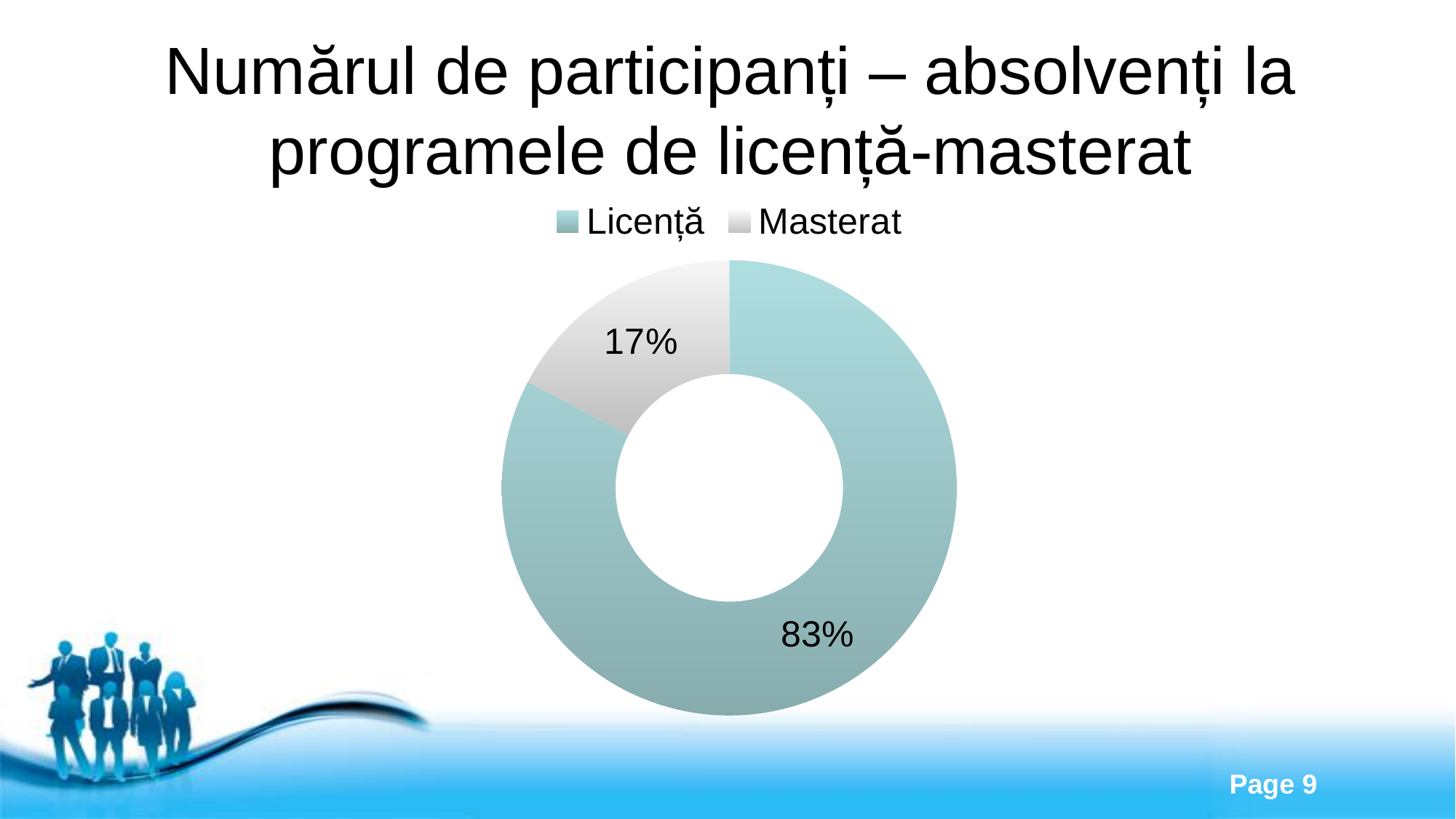
Which is larger, the share for Licență or the share for Masterat? Licență What share of the chart does Licență represent? 83% Which category has the smallest share? Masterat Which category has the largest share? Licență What kind of chart is shown on the slide? Doughnut chart What colour is the Masterat slice? Light grey What is the title of the slide? Numărul de participanți – absolvenți la programele de licență-masterat What is the difference in percentage points between the Licență and Masterat shares? 66 How many entries does the legend list? 2 What share of the chart does Masterat represent? 17% How many categories are shown in the chart? 2